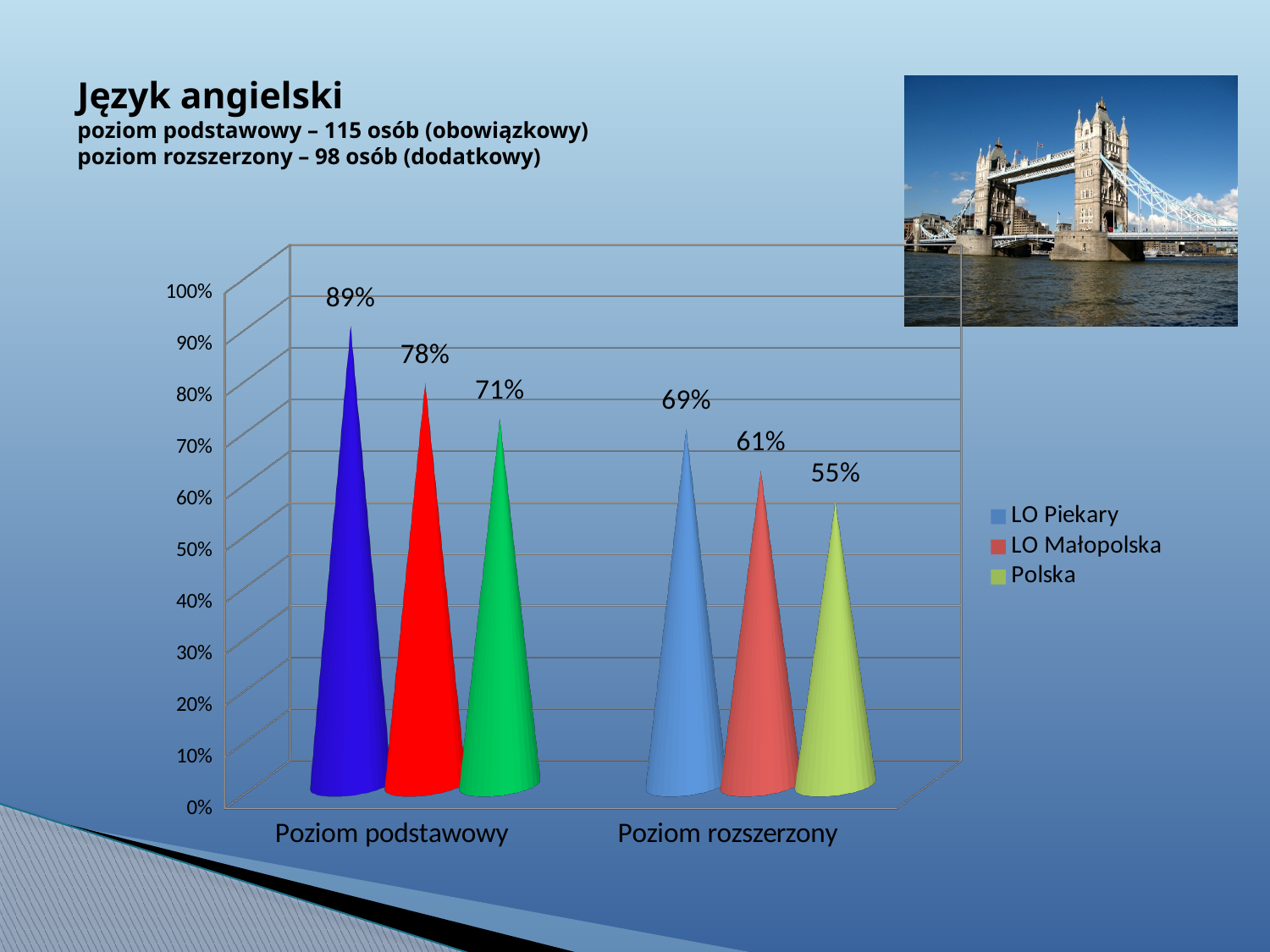
How many categories are shown on the x axis? 2 Which series has the highest value at Poziom rozszerzony? LO Piekary How many series does the legend list? 3 What is the difference between LO Małopolska and Polska at Poziom rozszerzony? 6% What is the value for Polska at Poziom rozszerzony? 55% Which is larger: LO Małopolska at Poziom podstawowy or LO Piekary at Poziom rozszerzony? LO Małopolska at Poziom podstawowy Which series has the lowest value at Poziom podstawowy? Polska What kind of chart is shown on the slide? Bar chart What is the value for LO Piekary at Poziom rozszerzony? 69% What is the difference between LO Piekary and Polska at Poziom podstawowy? 18% What is the value for LO Piekary at Poziom podstawowy? 89% What is the value for LO Małopolska at Poziom podstawowy? 78%